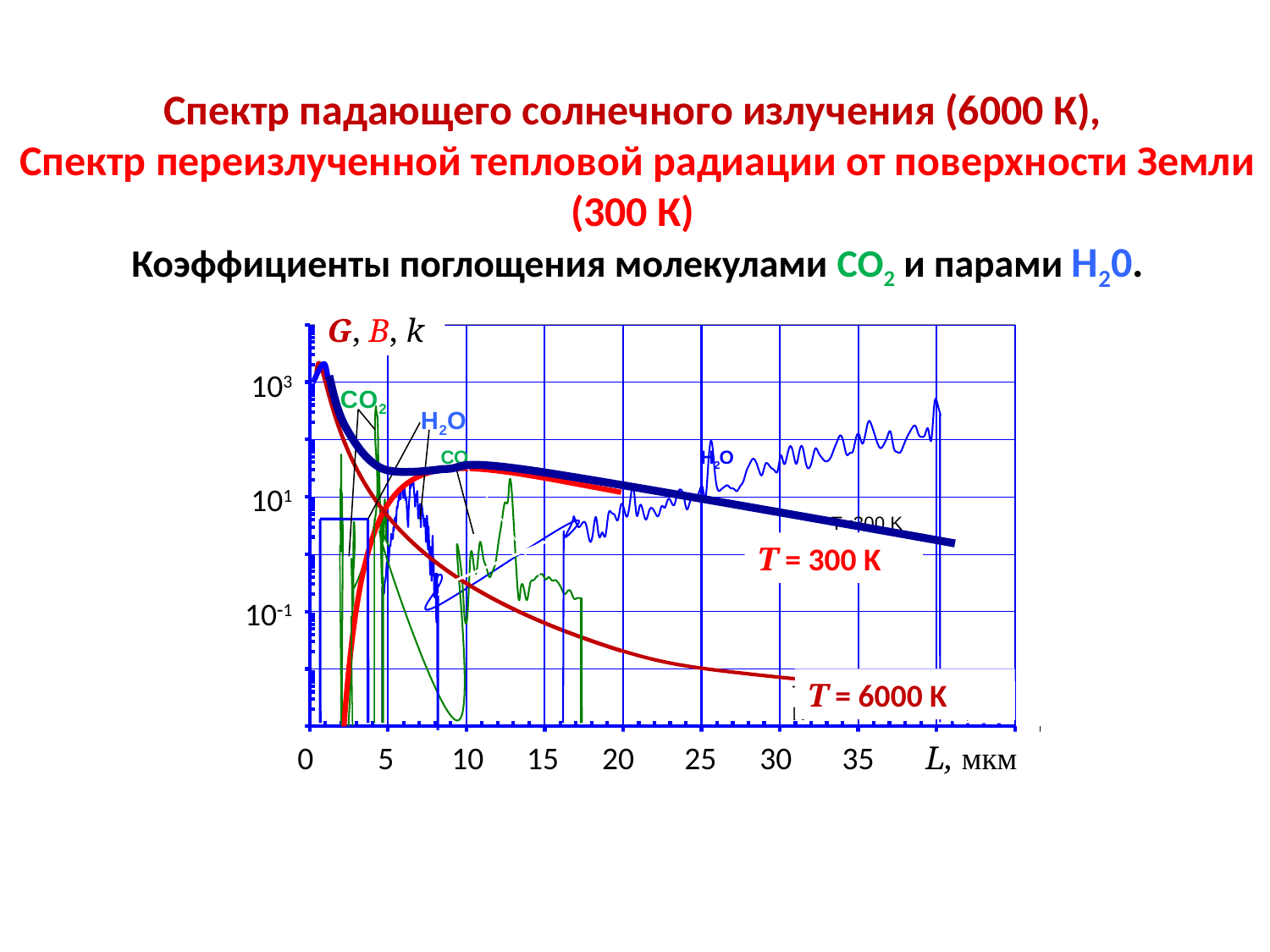
How many labelled tick values are shown on the x axis of the chart? 8 What is the label of the x axis of the chart? L, мкм Which molecules are labelled on the absorption coefficient curves in the chart? CO2 and H2O What kind of chart is shown on the slide? line chart Is the value of the T = 300 K curve at L = 10 мкм greater or less than 10^1? greater Is the peak value of the T = 6000 K curve greater or less than 10^1? greater Is the value of the T = 6000 K curve at L = 30 мкм greater or less than 10^-1? less Which curve reaches its peak at a longer wavelength L, T = 300 K or T = 6000 K? T = 300 K Which two temperatures are labelled on the curves of the chart? T = 300 K and T = 6000 K Does the T = 6000 K curve rise or fall as L increases from 5 to 30 мкм? fall Does the T = 300 K curve rise or fall as L increases from 10 to 35 мкм? fall